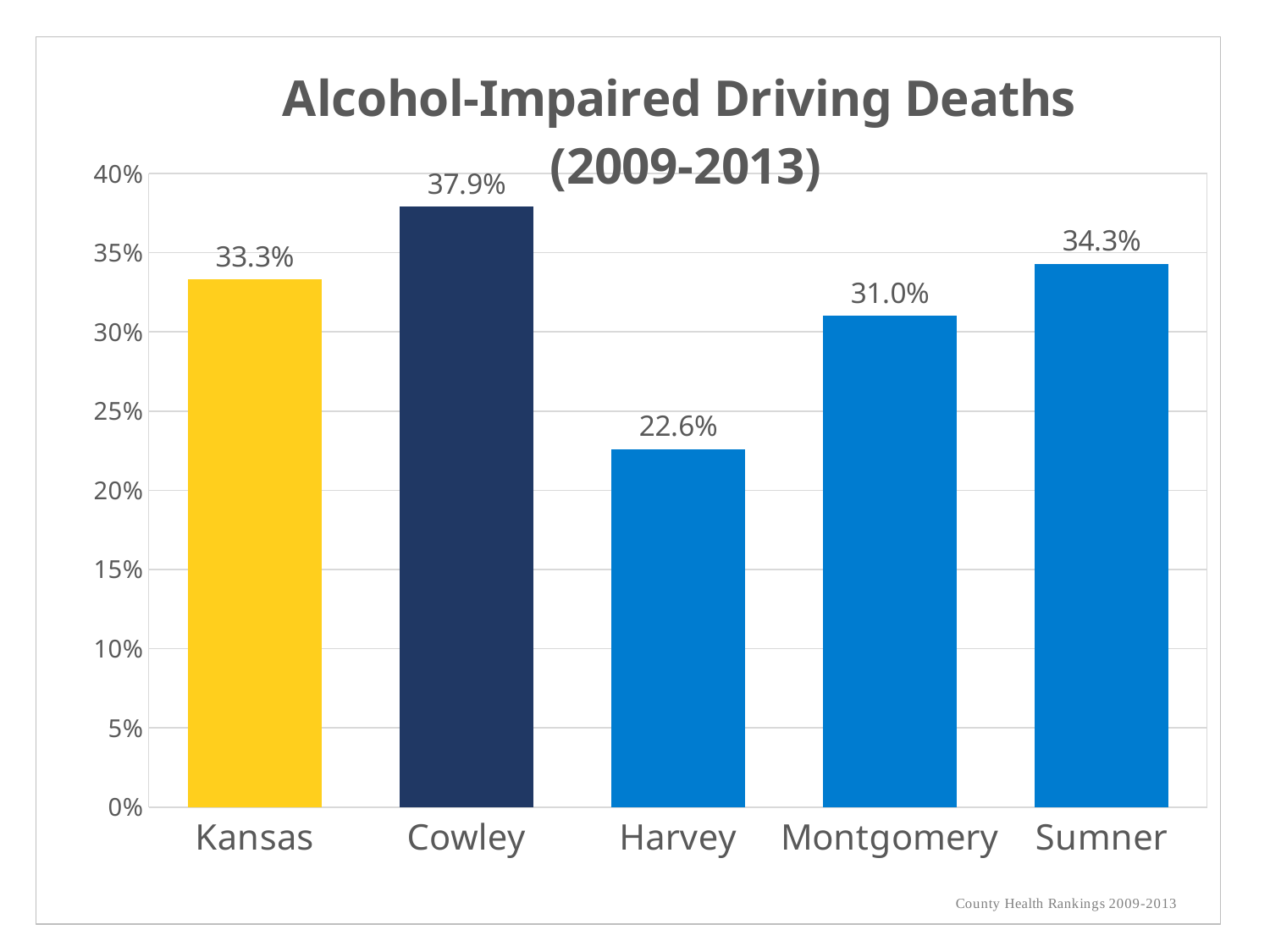
Which category has the lowest value? Harvey What is the title of the chart? Alcohol-Impaired Driving Deaths (2009-2013) What is the value for Cowley? 37.9% What is the value for Montgomery? 31.0% What is the difference between the values for Sumner and Kansas? 1.0% What is the value for Harvey? 22.6% What kind of chart is shown on the slide? Bar chart Which category has the highest value? Cowley What is the value for Kansas? 33.3% How many categories are shown on the x axis? 5 What is the difference between the values for Cowley and Harvey? 15.3% Which is larger, the value for Montgomery or the value for Sumner? Sumner